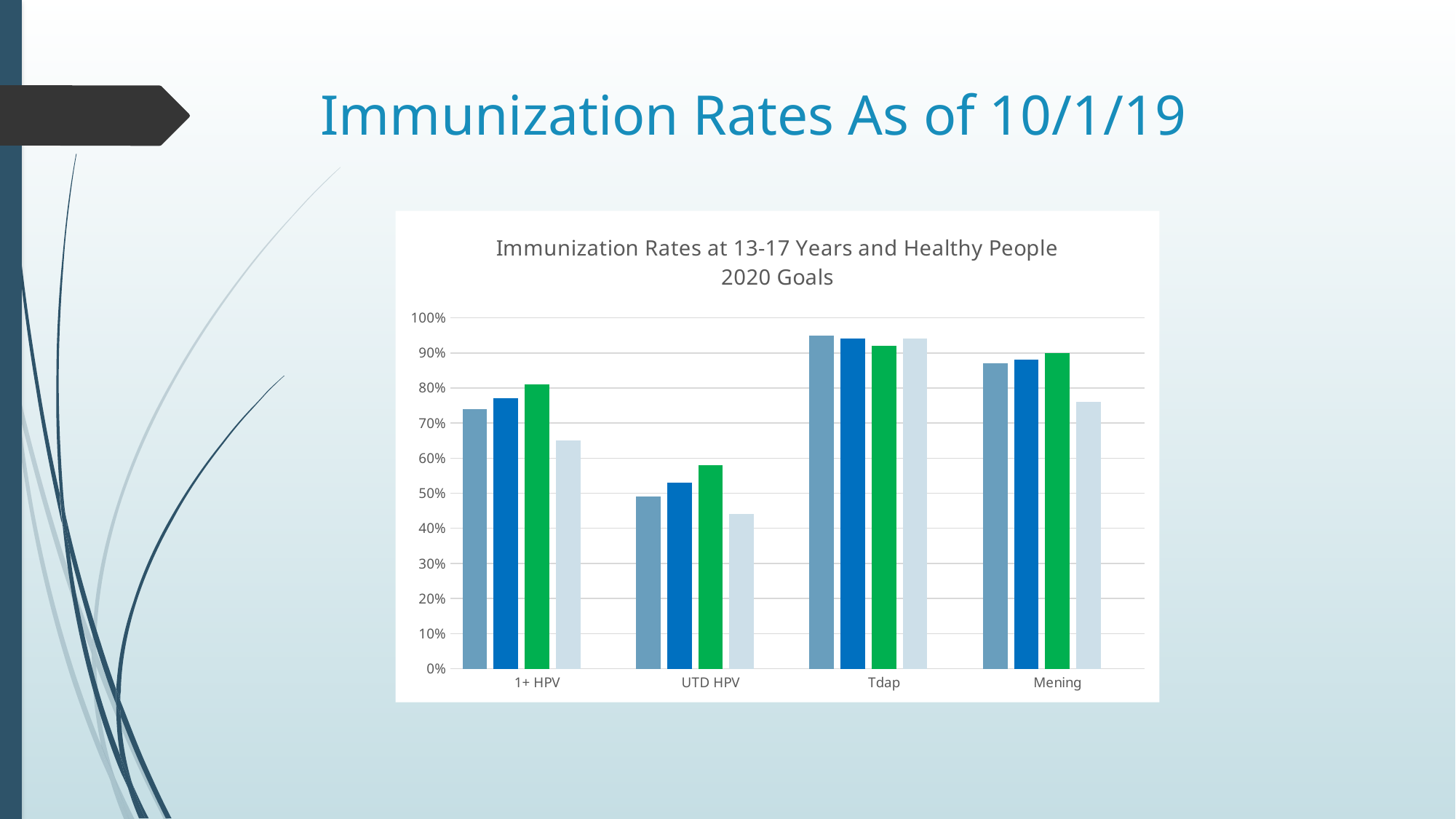
What is the highest value shown on the y axis of the chart? 100% Are all the bars for UTD HPV greater or less than 60%? less What kind of chart is shown on the slide? bar chart How many bars are plotted for each category in the chart? 4 How many categories are shown on the x axis of the chart? 4 Are all the bars for Tdap greater or less than 90%? greater Which category has the lowest bars in the chart? UTD HPV Which category has higher bars, 1+ HPV or UTD HPV? 1+ HPV Are all the bars for 1+ HPV greater or less than 60%? greater Which category has the highest bars in the chart? Tdap Which category has higher bars, Tdap or UTD HPV? Tdap What is the title of the chart? Immunization Rates at 13-17 Years and Healthy People 2020 Goals